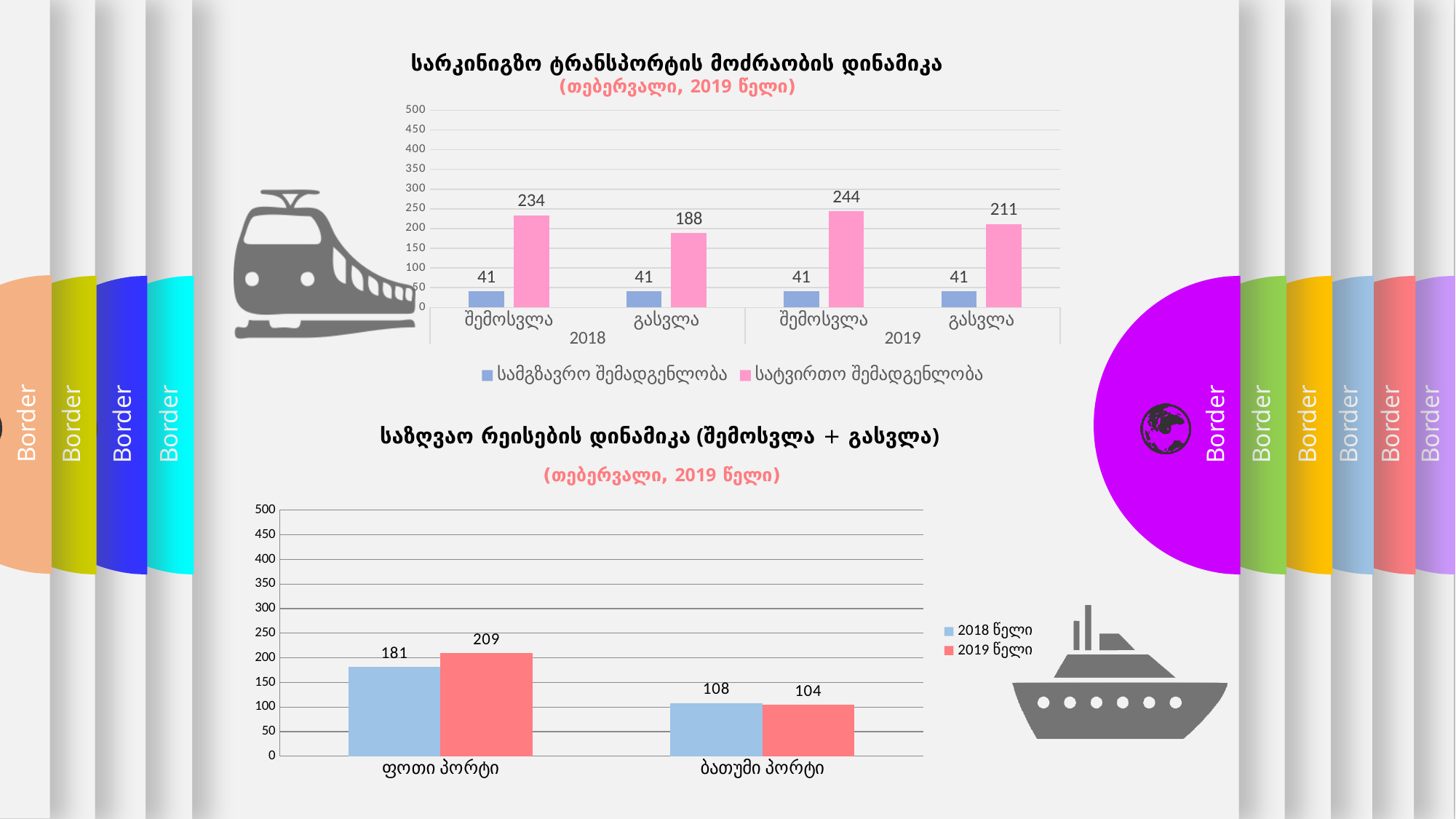
How many series does the legend of the top chart (railway transport) list? 2 What type of chart is the bottom chart (sea voyages)? Bar chart In the top chart (railway transport), which category has the lowest სატვირთო შემადგენლობა value? გასვლა 2018 In the top chart (railway transport), what is the value of სატვირთო შემადგენლობა for გასვლა in 2019? 211 In the bottom chart (sea voyages), which is larger for ბათუმი პორტი: the 2018 წელი value or the 2019 წელი value? 2018 წელი In the bottom chart (sea voyages), what is the difference between the 2019 წელი and 2018 წელი values for ფოთი პორტი? 28 In the top chart (railway transport), what is the value of სამგზავრო შემადგენლობა for შემოსვლა in 2019? 41 In the bottom chart (sea voyages), what is the value for ბათუმი პორტი in 2018 წელი? 108 In the top chart (railway transport), which category has the highest სატვირთო შემადგენლობა value? შემოსვლა 2019 In the top chart (railway transport), what is the value of სატვირთო შემადგენლობა for შემოსვლა in 2018? 234 In the top chart (railway transport), what is the difference between the სატვირთო შემადგენლობა values for შემოსვლა 2019 and შემოსვლა 2018? 10 In the bottom chart (sea voyages), what is the value for ფოთი პორტი in 2019 წელი? 209